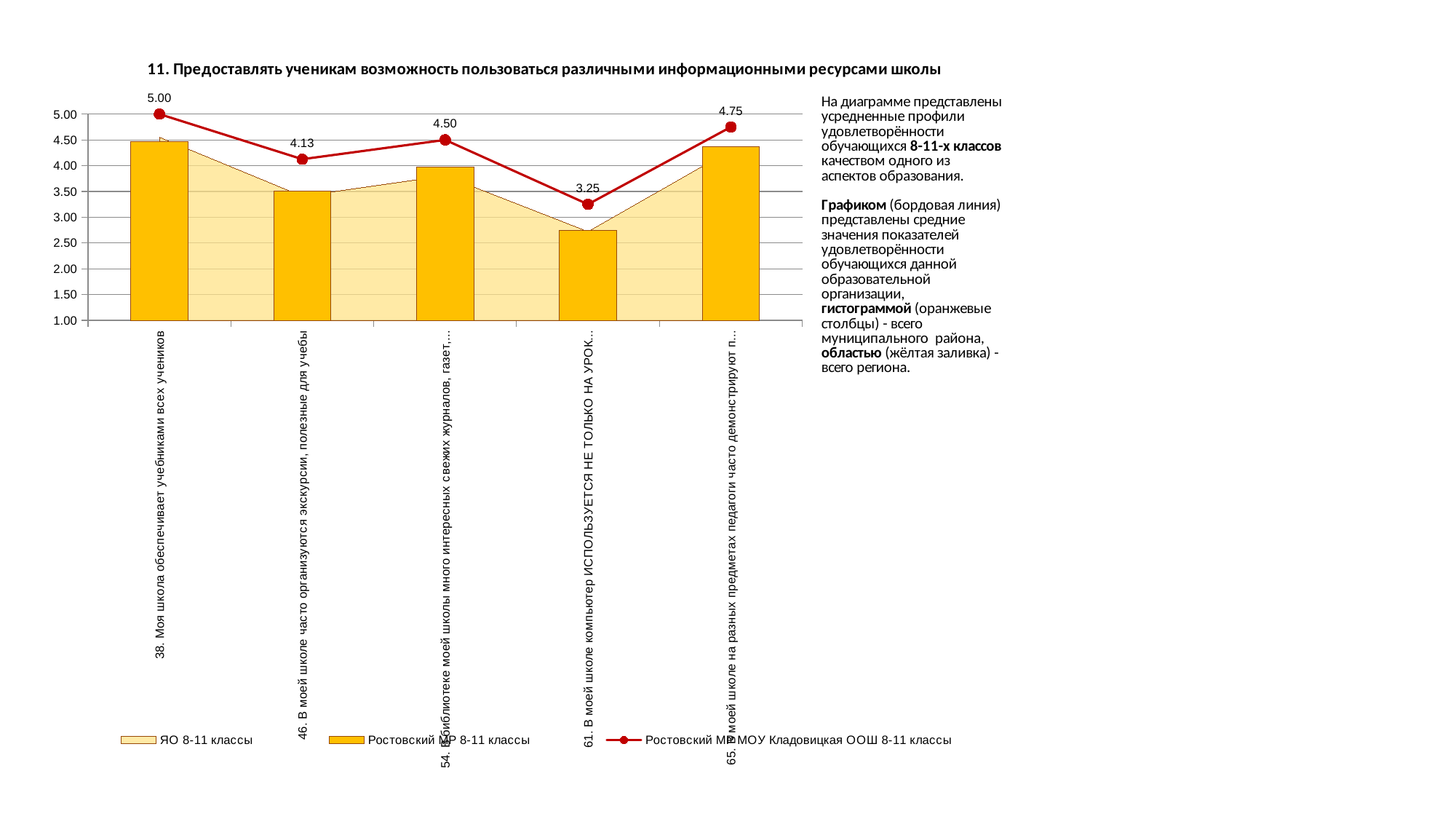
On the Ростовский МР МОУ Кладовицкая ООШ 8-11 классы line, which is larger: the value for item 54 or the value for item 65? Item 65 (4.75) How many items (categories) are shown on the x axis of the chart? 5 What is the value of the Ростовский МР МОУ Кладовицкая ООШ 8-11 классы line for item 38 (Моя школа обеспечивает учебниками всех учеников)? 5.00 For which item does the Ростовский МР МОУ Кладовицкая ООШ 8-11 классы line reach its highest value? 38. Моя школа обеспечивает учебниками всех учеников Which series in the legend is drawn as a line with markers? Ростовский МР МОУ Кладовицкая ООШ 8-11 классы What is the difference between the highest and lowest values of the Ростовский МР МОУ Кладовицкая ООШ 8-11 классы line? 1.75 How many series does the chart legend list? 3 Is the Ростовский МР 8-11 классы bar for item 61 greater or less than 3.00? less What is the value of the Ростовский МР МОУ Кладовицкая ООШ 8-11 классы line for item 61 (В моей школе компьютер используется не только на уроках)? 3.25 For which item does the Ростовский МР МОУ Кладовицкая ООШ 8-11 классы line have its lowest value? 61. В моей школе компьютер используется не только на уроках Is the Ростовский МР 8-11 классы bar for item 38 greater or less than 4.00? greater What is the value of the Ростовский МР МОУ Кладовицкая ООШ 8-11 классы line for item 46 (В моей школе часто организуются экскурсии, полезные для учебы)? 4.13